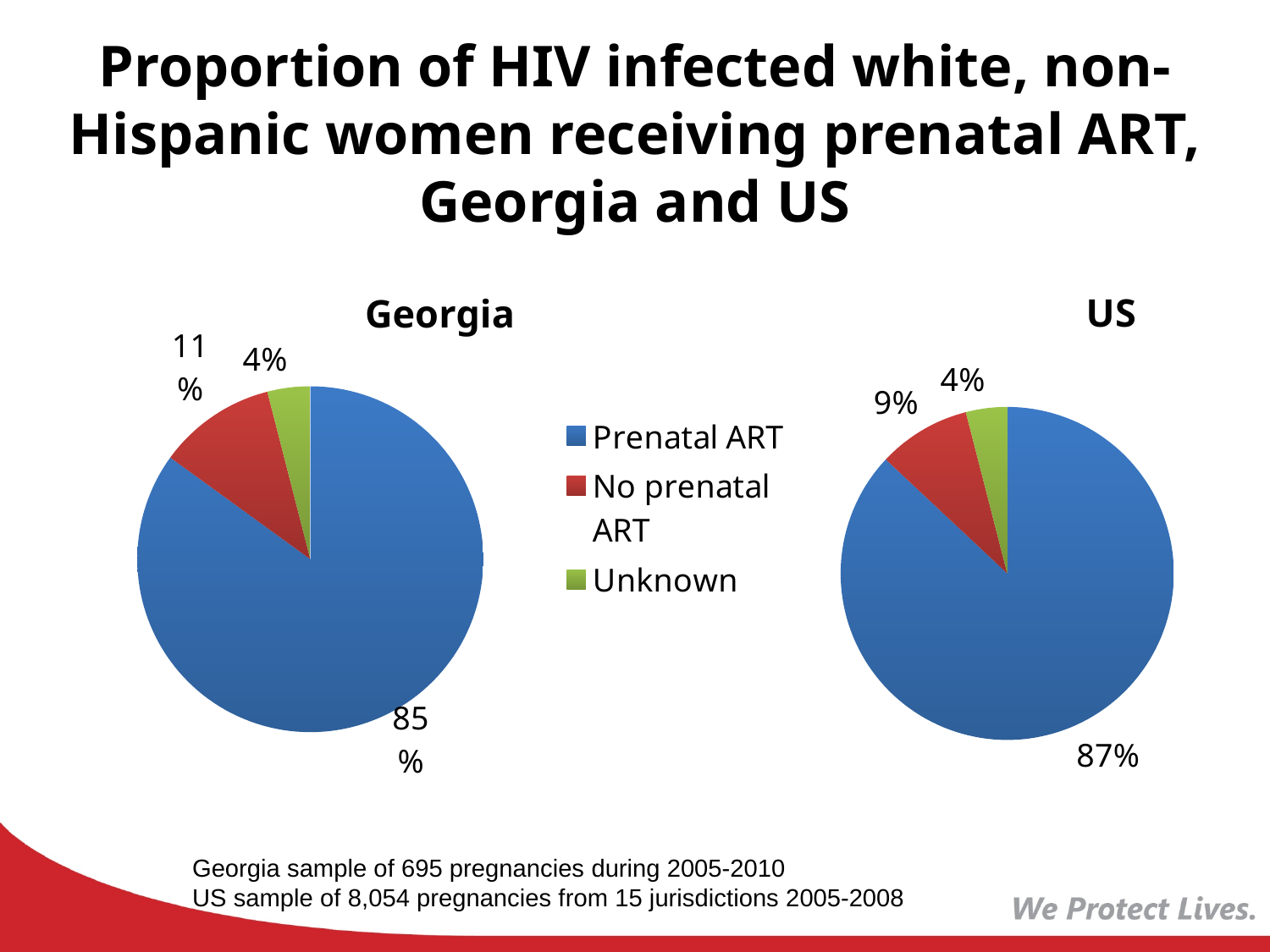
What type of chart is used for the Georgia and US data? Pie chart In the Georgia pie chart, what percentage of women received prenatal ART? 85% In the US pie chart, what percentage of women received no prenatal ART? 9% In the US pie chart, what is the share of the Unknown slice? 4% Which chart shows a larger No prenatal ART share, Georgia or US? Georgia What is the difference between the Prenatal ART percentage in the US chart and in the Georgia chart? 2% In the US pie chart, which category has the smallest slice? Unknown In the Georgia pie chart, what percentage of women received no prenatal ART? 11% In the US pie chart, what percentage of women received prenatal ART? 87% In the Georgia pie chart, which category has the largest slice? Prenatal ART How many categories does the legend list for the pie charts? 3 In the Georgia pie chart, what is the share of the Unknown slice? 4%